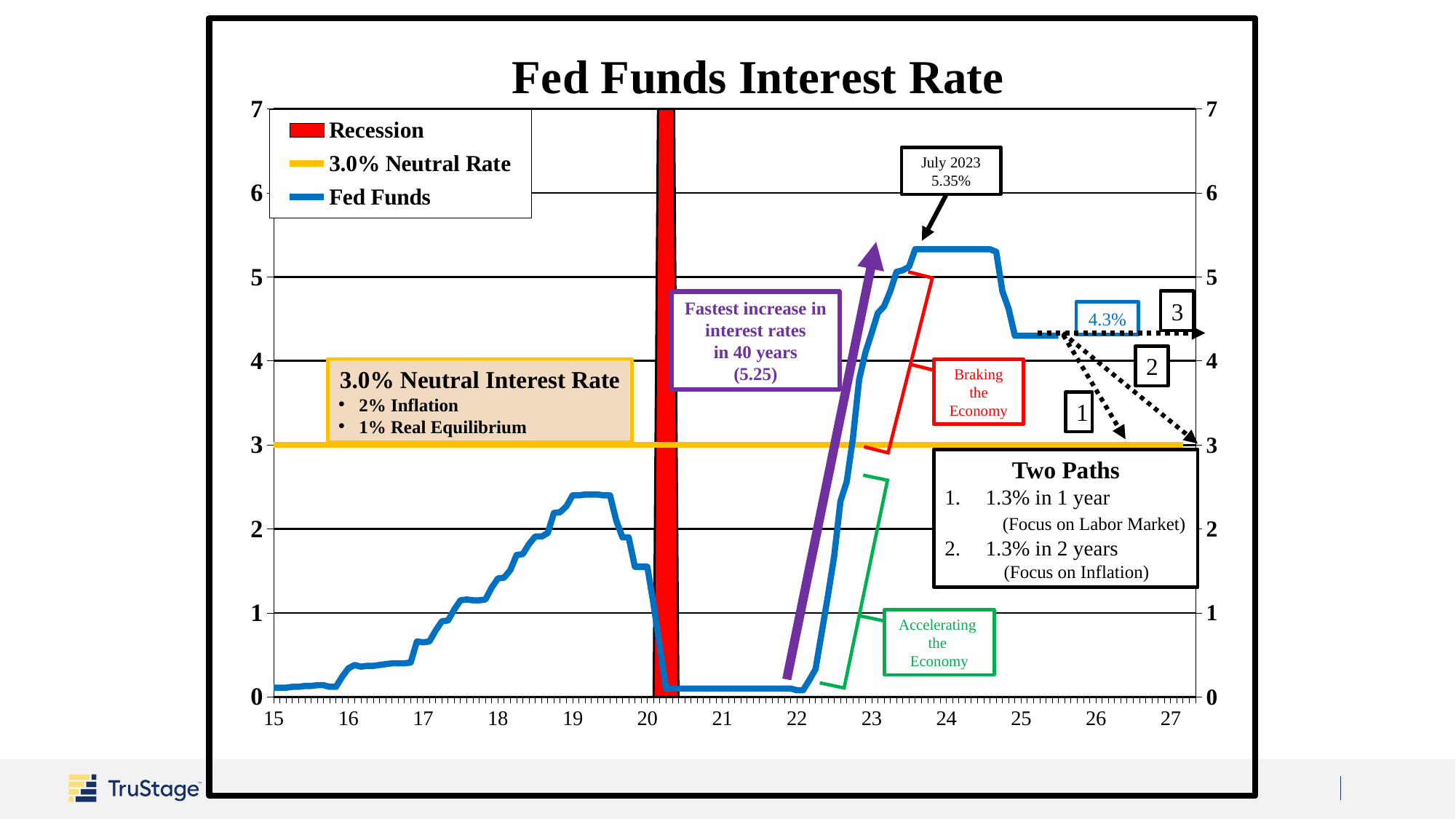
Is the Fed Funds rate at the start of 2019 greater or less than 2? greater Does the Fed Funds rate rise or fall between 2022 and 2023? rise What kind of chart is shown on the slide? line chart What is the title of the chart? Fed Funds Interest Rate What Fed Funds value is labeled on the flat segment of the line around 2025? 4.3% According to the annotation, what was the Fed Funds rate in July 2023? 5.35% What value is the neutral interest rate line drawn at? 3.0% What does the red shaded vertical band on the chart represent? Recession What is the difference between the July 2023 Fed Funds rate (5.35%) and the 3.0% neutral rate? 2.35% How many entries does the chart's legend list? 3 Is the Fed Funds rate during 2021 greater or less than 1? less Which is higher, the Fed Funds rate in 2024 or in 2017? 2024